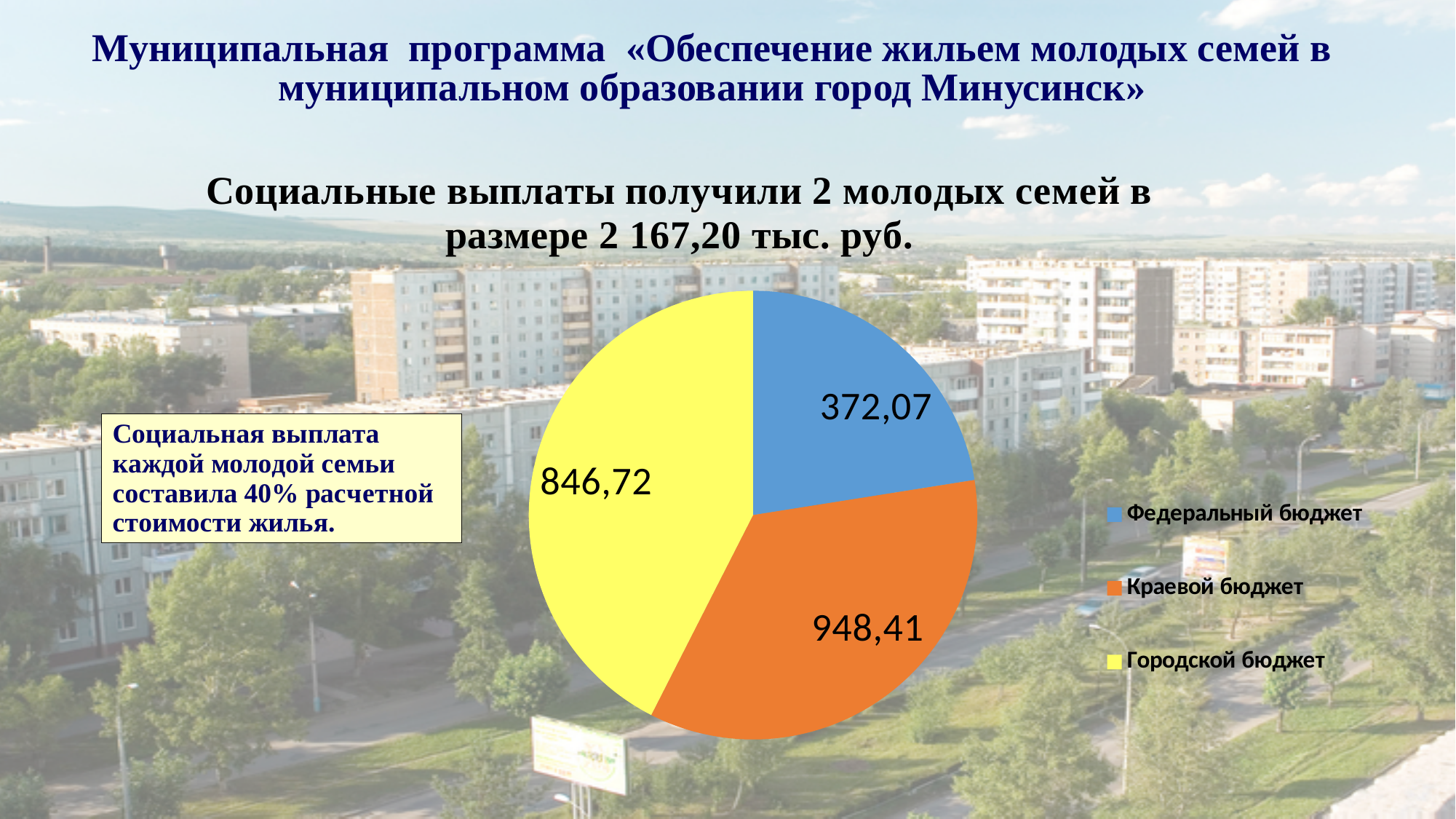
What type of chart is shown on the slide? Pie chart How many entries does the legend of the pie chart list? 3 What is the value for Федеральный бюджет in the pie chart? 372,07 Which is larger: the value for Городской бюджет or the value for Федеральный бюджет? Городской бюджет What is the difference between the values for Краевой бюджет and Городской бюджет? 101,69 What is the difference between the values for Городской бюджет and Федеральный бюджет? 474,65 What colour is the slice for Городской бюджет in the pie chart? Yellow What is the value for Краевой бюджет in the pie chart? 948,41 What is the value for Городской бюджет in the pie chart? 846,72 Which budget source has the smallest slice in the pie chart? Федеральный бюджет How many slices does the pie chart have? 3